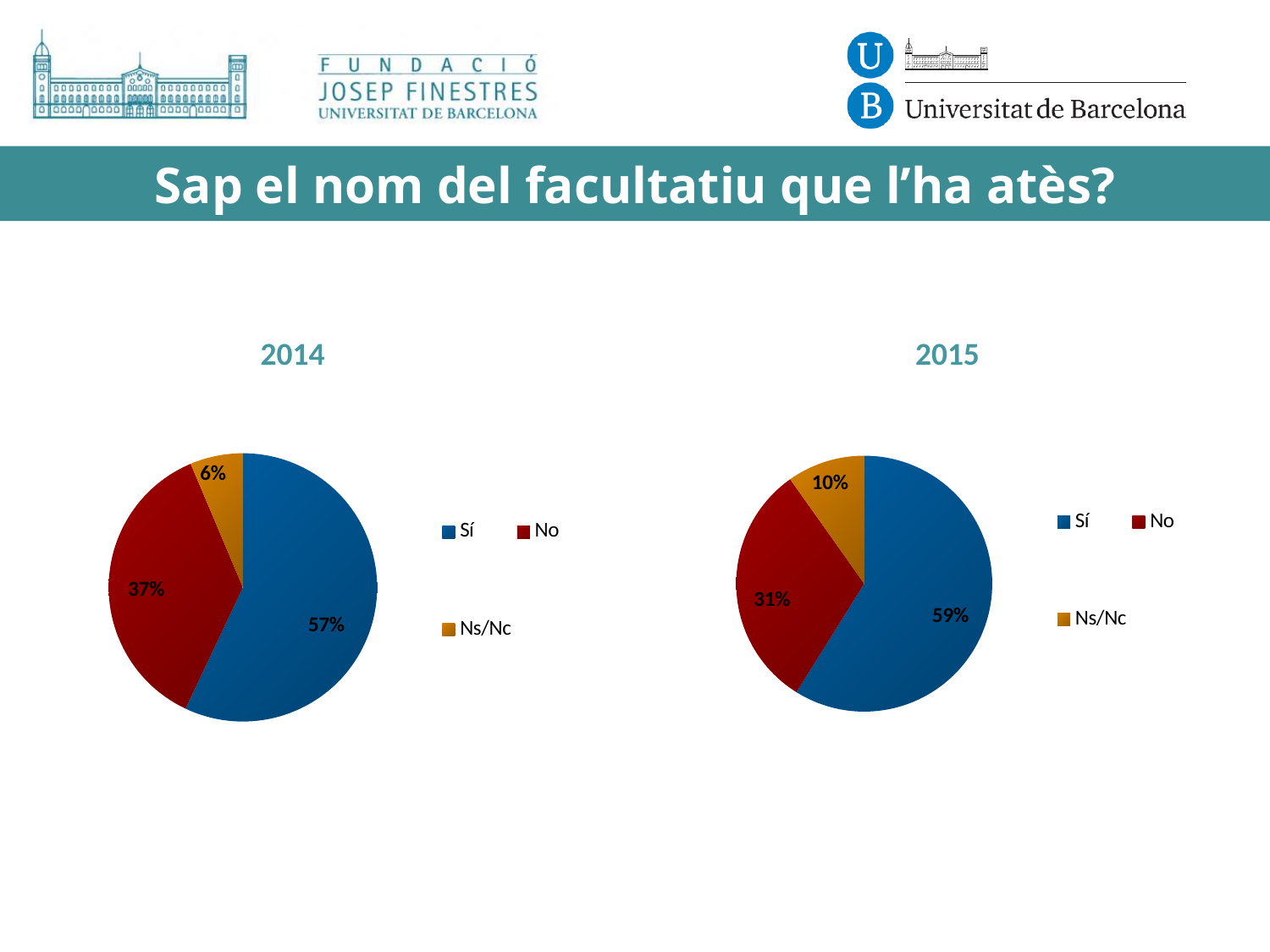
In the 2014 pie chart, what percentage is shown for No? 37% In the 2015 pie chart, what percentage is shown for Ns/Nc? 10% In the 2014 pie chart, what percentage is shown for Sí? 57% In the 2015 pie chart, what is the difference between the Sí and No percentages? 28% In the 2015 pie chart, which category has the smallest slice? Ns/Nc What type of chart is used for the 2015 data? Pie chart In the 2015 pie chart, what percentage is shown for Sí? 59% In the 2014 pie chart, what percentage is shown for Ns/Nc? 6% In the 2015 pie chart, what percentage is shown for No? 31% How many slices does the 2014 pie chart have? 3 Is the Ns/Nc share larger in the 2014 pie chart or the 2015 pie chart? 2015 In the 2014 pie chart, which category has the largest slice? Sí